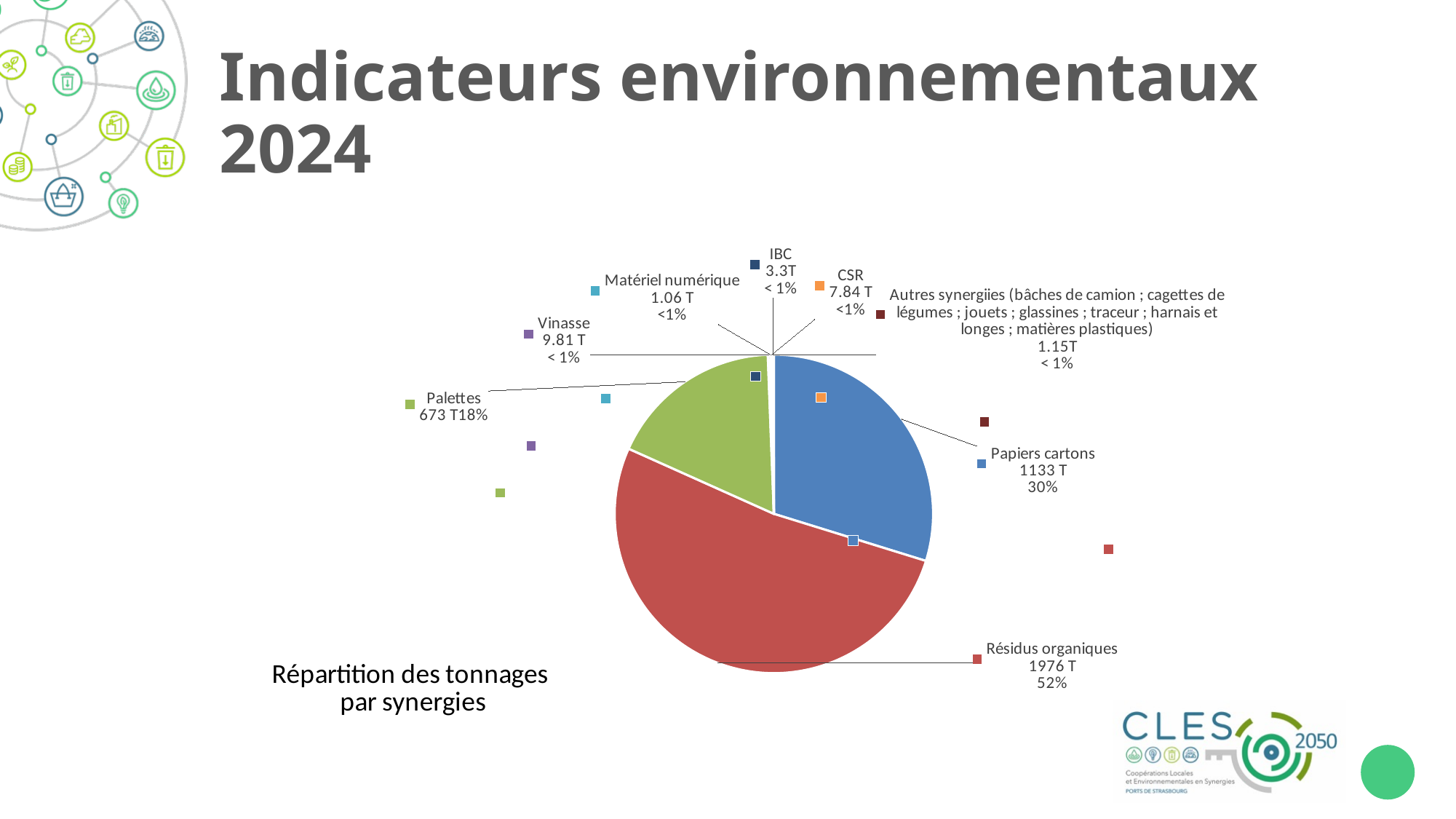
What share of the pie does Papiers cartons represent? 30% What is the tonnage for Palettes? 673 T What is the tonnage for Vinasse? 9.81 T What kind of chart is shown on the slide? pie chart How many categories are shown in the pie chart? 8 What is the tonnage for CSR? 7.84 T What share of the pie does Résidus organiques represent? 52% What is the caption of the pie chart? Répartition des tonnages par synergies What is the difference in tonnage between Résidus organiques and Papiers cartons? 843 T What is the tonnage for Résidus organiques? 1976 T Which is larger in tonnage, Papiers cartons or Palettes? Papiers cartons Which category has the largest share of the pie? Résidus organiques